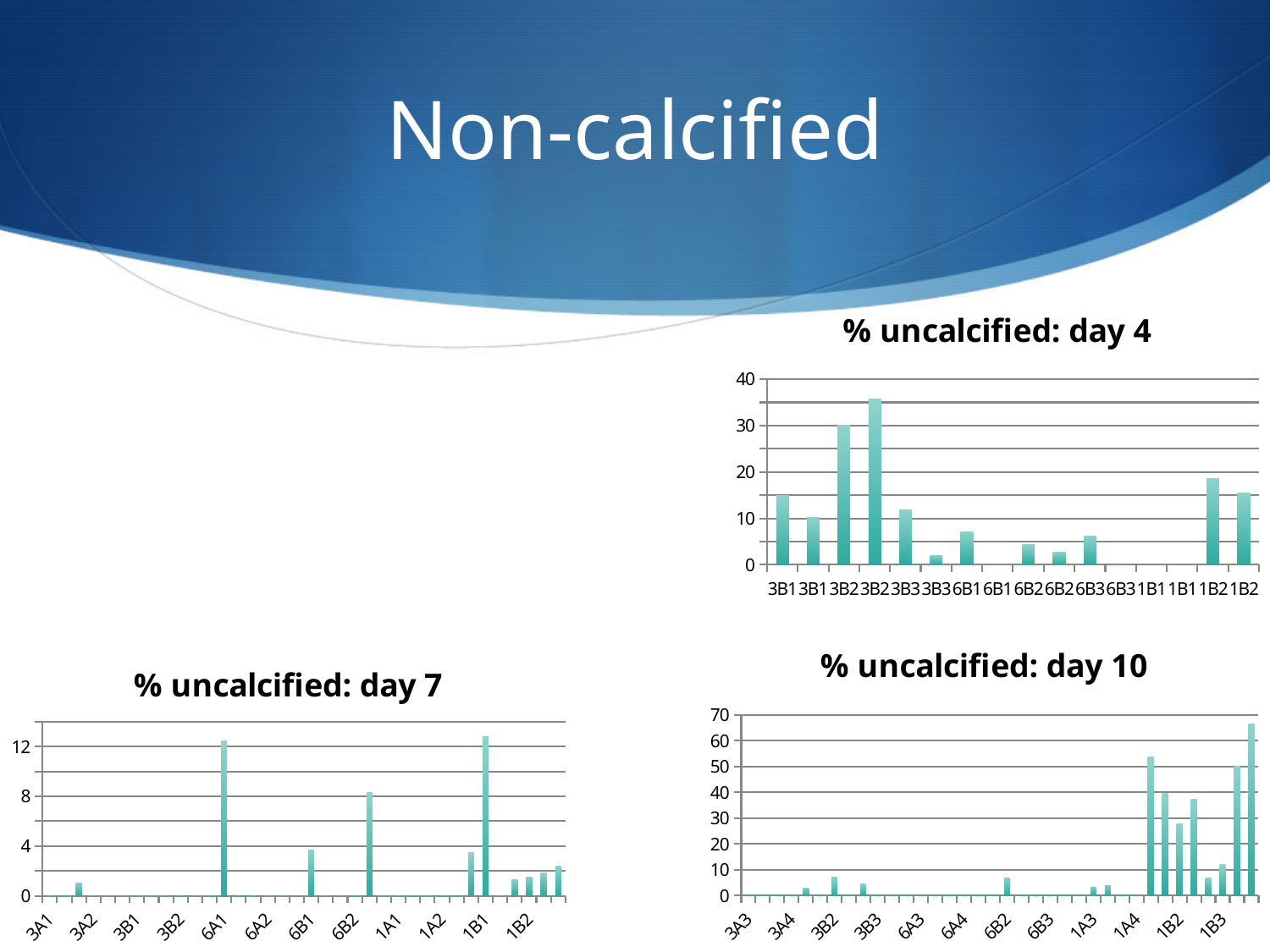
In the '% uncalcified: day 10' chart, is the tallest bar greater or less than 60? greater In the '% uncalcified: day 7' chart, is the value of the bar at 3A2 greater or less than 4? less How many charts are shown on the slide? 3 In the '% uncalcified: day 4' chart, which is larger, the tallest 3B2 bar or the tallest 6B1 bar? 3B2 What is the title of the chart in the top right of the slide? % uncalcified: day 4 In the '% uncalcified: day 4' chart, is the value of the first 3B1 bar greater or less than 10? greater What kind of chart is the '% uncalcified: day 4' chart? bar chart In the '% uncalcified: day 4' chart, which category has the tallest bar? 3B2 In the '% uncalcified: day 4' chart, how many category labels are on the x axis? 16